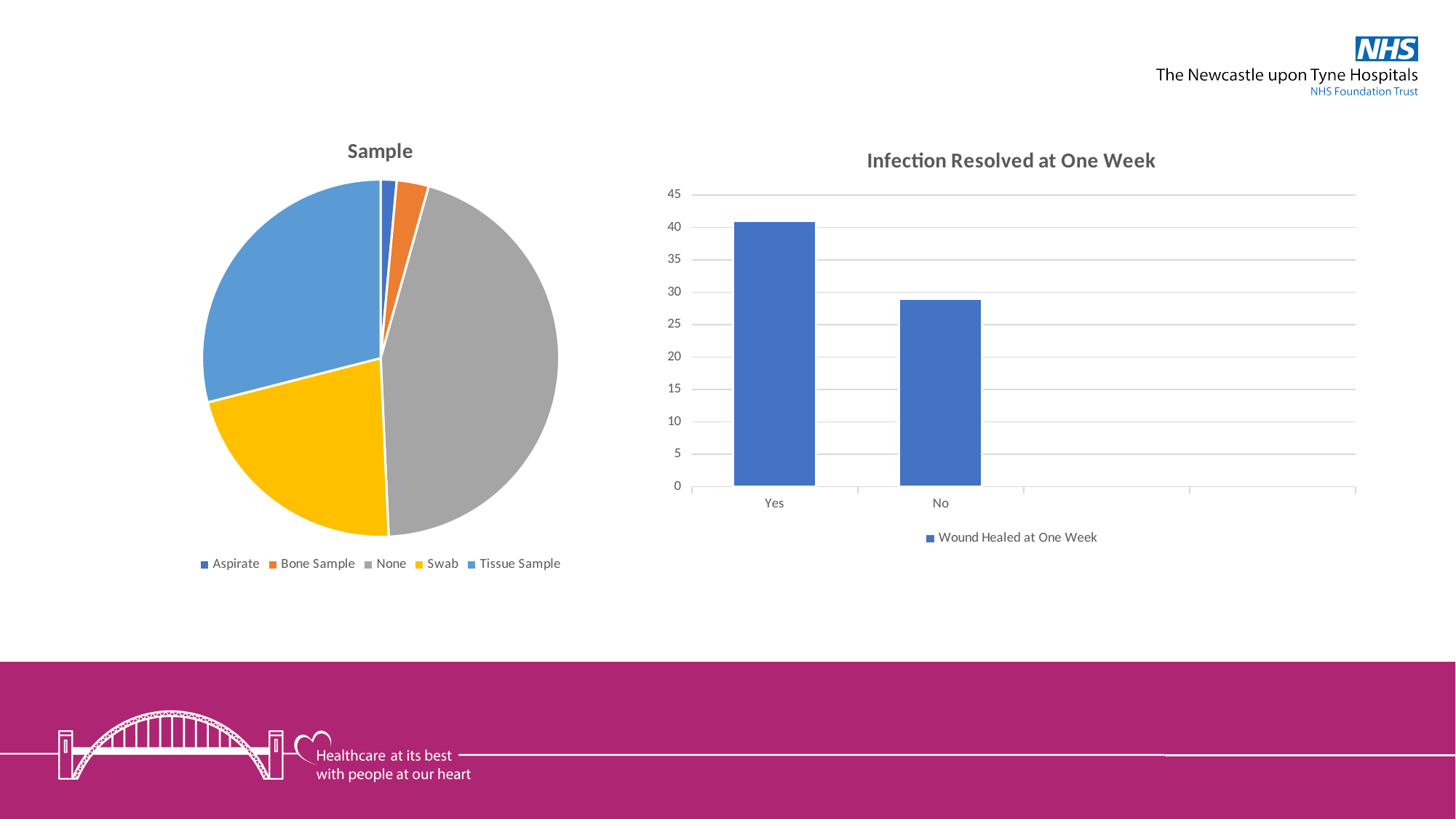
What kind of chart is the "Infection Resolved at One Week" chart? bar chart In the "Sample" pie chart, which category has the largest slice? None In the "Sample" pie chart, how many categories does the legend list? 5 What kind of chart is the "Sample" chart? pie chart In the "Infection Resolved at One Week" chart, how many series does the legend list? 1 In the "Infection Resolved at One Week" chart, which category has the higher bar? Yes What is the legend entry shown below the "Infection Resolved at One Week" chart? Wound Healed at One Week In the "Sample" pie chart, which slice is larger, Swab or Bone Sample? Swab In the "Sample" pie chart, which category has the smallest slice? Aspirate In the "Infection Resolved at One Week" chart, how many bars are plotted? 2